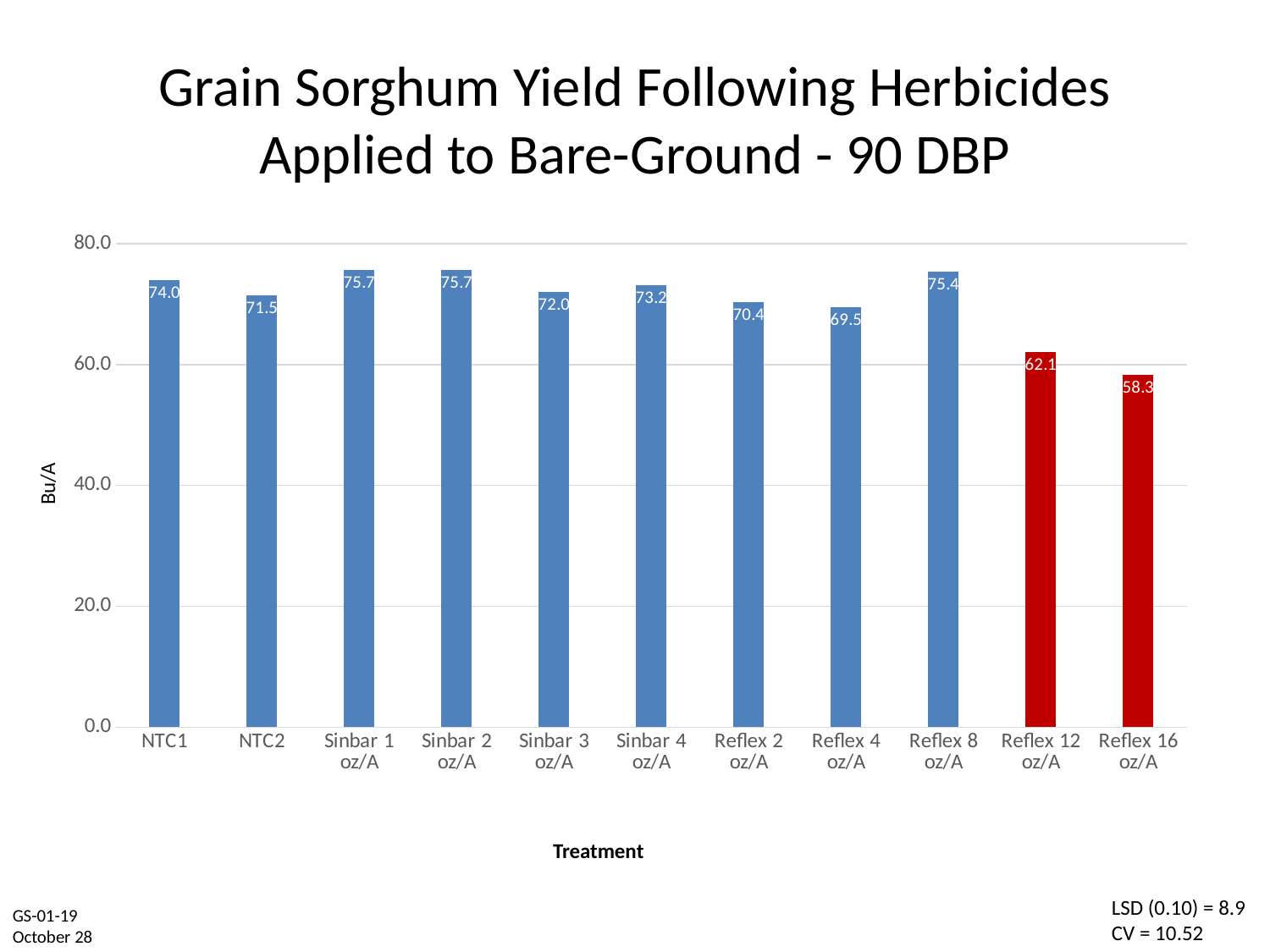
What is the yield for Reflex 12 oz/A? 62.1 What is the yield for Reflex 8 oz/A? 75.4 Which has a higher yield, NTC2 or Reflex 4 oz/A? NTC2 What is the yield for Sinbar 3 oz/A? 72.0 What is the yield for NTC1? 74.0 What kind of chart is shown on the slide? Bar chart Which treatment has the lowest yield? Reflex 16 oz/A What is the difference in yield between Reflex 12 oz/A and Reflex 16 oz/A? 3.8 Is the value for Reflex 12 oz/A greater or less than 60.0? greater What is the difference in yield between NTC1 and Reflex 16 oz/A? 15.7 What is the label on the vertical axis? Bu/A How many treatments are shown on the chart? 11